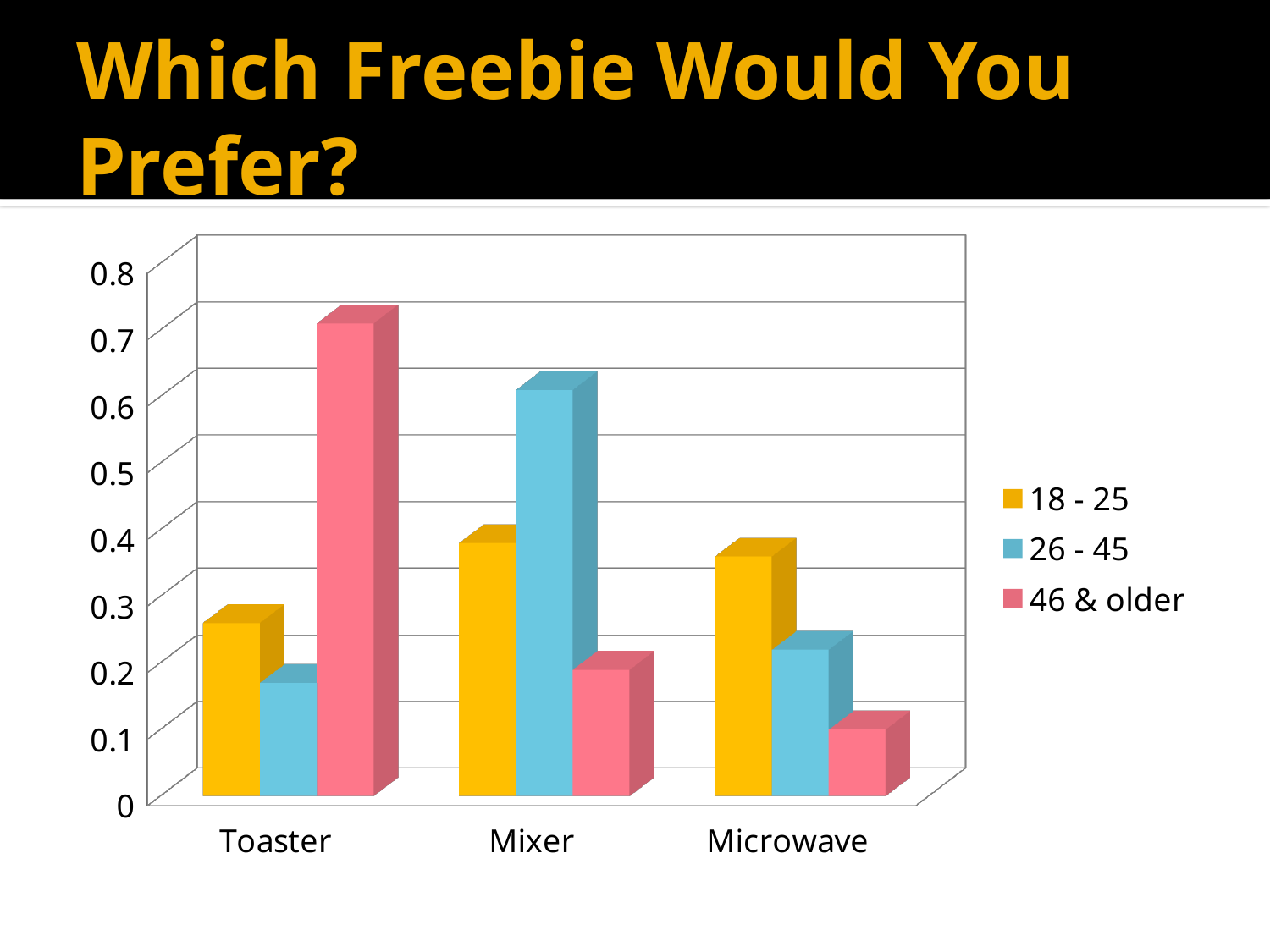
What kind of chart is shown on the slide? bar chart How many categories are shown on the x axis of the chart? 3 Is the value for 46 & older at Microwave greater or less than 0.2? less Which is larger: the 46 & older value for Toaster or the 26 - 45 value for Mixer? 46 & older value for Toaster Which colour represents the 46 & older series in the chart? pink Which category has the highest value for the 46 & older series? Toaster Which category has the lowest value for the 46 & older series? Microwave Which series has the highest value for Mixer? 26 - 45 Is the value for 26 - 45 at Toaster greater or less than 0.3? less What is the title of the slide containing the chart? Which Freebie Would You Prefer? How many series does the legend list? 3 Is the value for 46 & older at Toaster greater or less than 0.6? greater